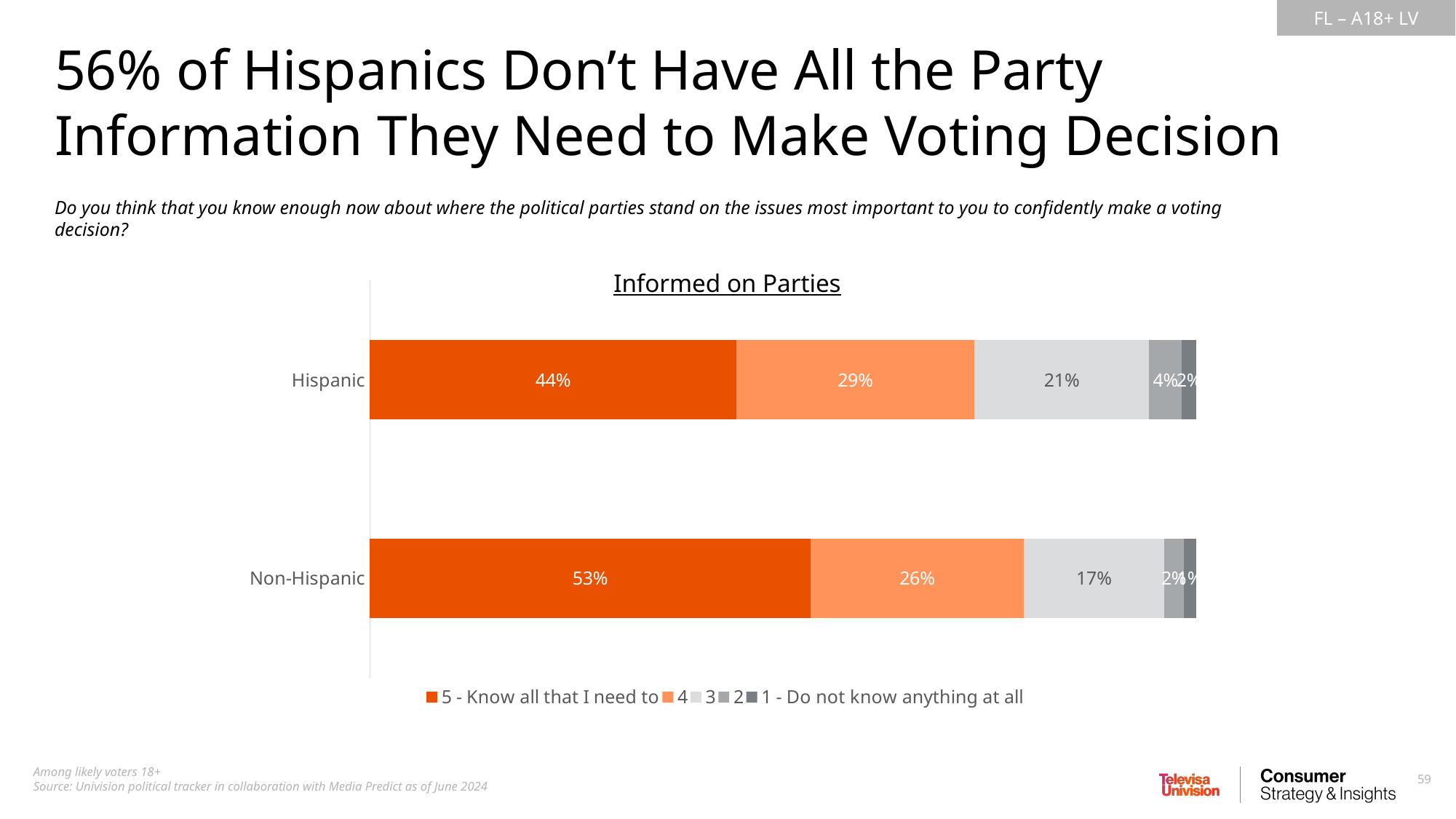
How many categories are plotted on the chart? 2 What is the value for Hispanic in the '2' series? 4% How many series does the legend list? 5 What percentage of Hispanics answered '5 - Know all that I need to'? 44% Which category has the larger share for '5 - Know all that I need to', Hispanic or Non-Hispanic? Non-Hispanic What is the value for Non-Hispanic in the '3' series? 17% Which legend entry is shown in the darkest orange colour? 5 - Know all that I need to What kind of chart is shown on the slide? Stacked bar chart What percentage of Non-Hispanics answered '5 - Know all that I need to'? 53% What is the value for Hispanic in the '4' series? 29% What is the title of the chart? Informed on Parties What is the difference between the Non-Hispanic and Hispanic values for '5 - Know all that I need to'? 9 percentage points